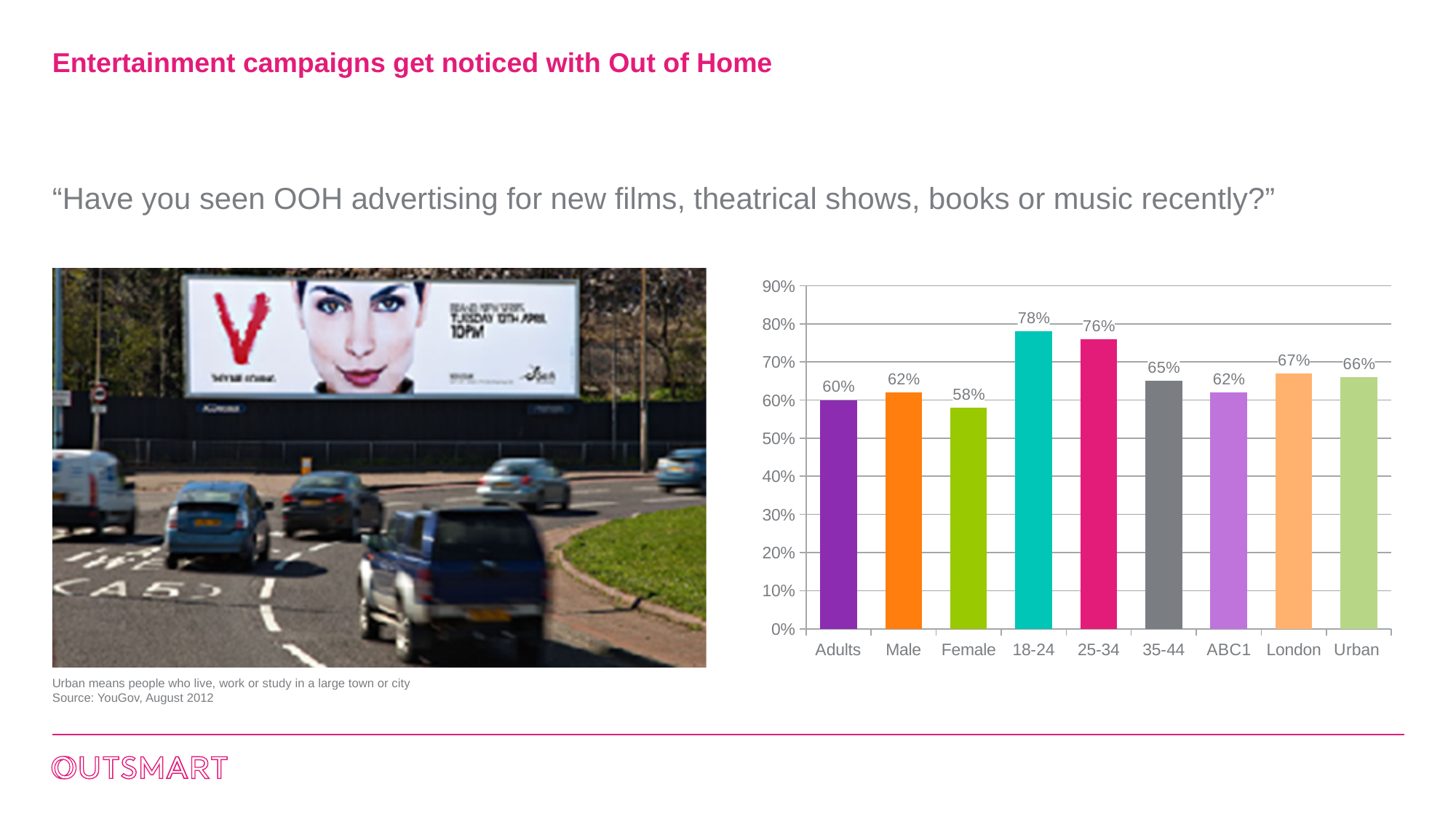
What percentage of Adults said they had seen OOH advertising for new films, theatrical shows, books or music recently? 60% Which is larger, the value for 25-34 or the value for ABC1? 25-34 What kind of chart is shown on the slide? Bar chart What is the value shown for the 18-24 age group? 78% What is the difference between the 18-24 and 35-44 values? 13% What is the difference between the Male and Female values? 4% What is the value shown for London? 67% Which category has the lowest value in the chart? Female How many categories are shown on the x axis of the chart? 9 Which category has the highest value in the chart? 18-24 Is the value for Urban greater or less than 60%? greater What is the highest value shown on the chart's y axis? 90%